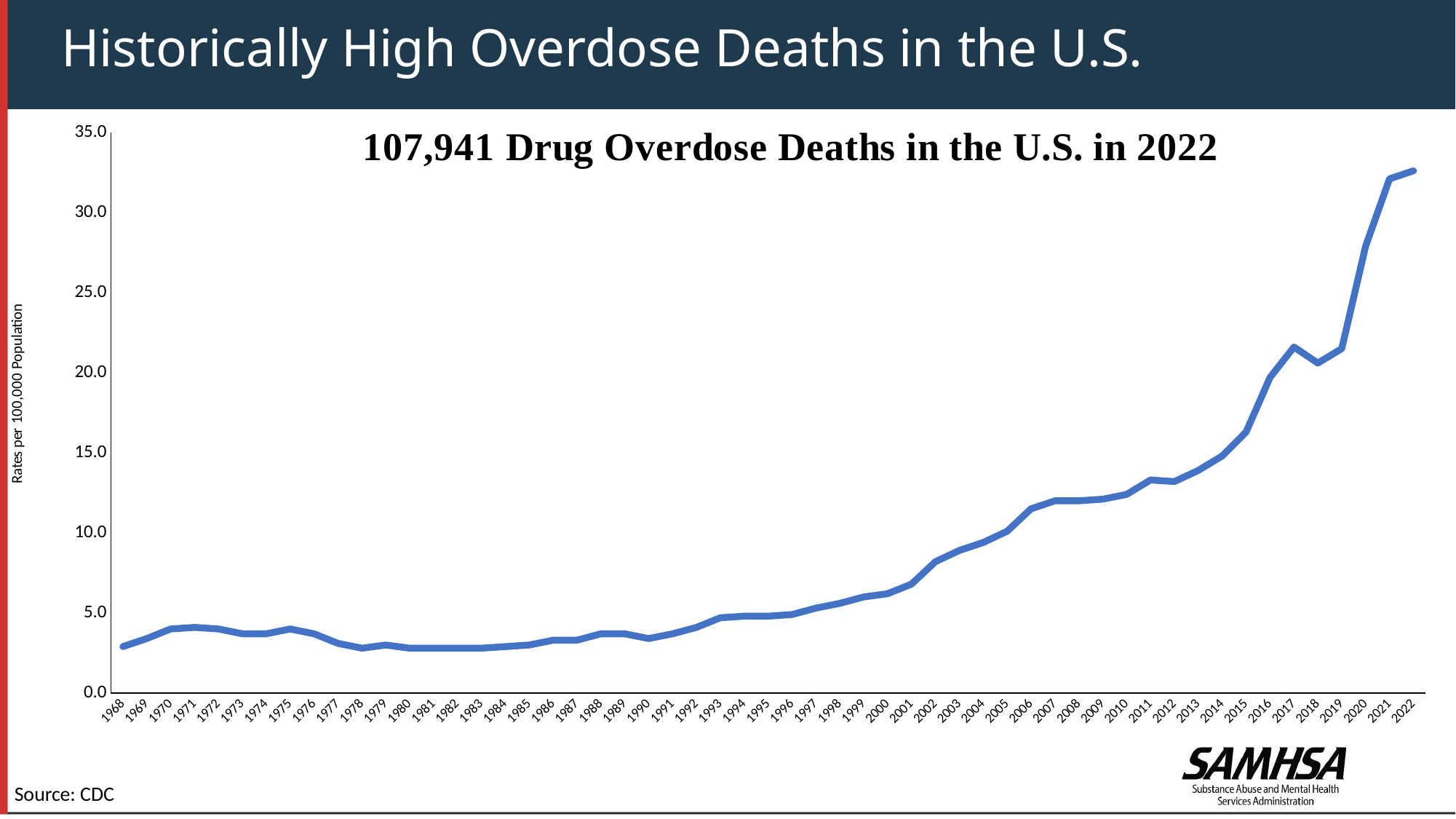
Which year has the larger value, 2017 or 2018? 2017 What is the title of the chart? 107,941 Drug Overdose Deaths in the U.S. in 2022 Which year has the highest overdose death rate on the chart? 2022 Is the value for 1990 greater or less than 5.0? less Overall, do the values rise or fall from 1968 to 2022? rise What kind of chart is shown on the slide? line chart Is the value for 2020 greater or less than 25.0? greater Is the value for 2017 greater or less than 20.0? greater What is the label on the vertical axis of the chart? Rates per 100,000 Population How many years are plotted along the x axis of the chart? 55